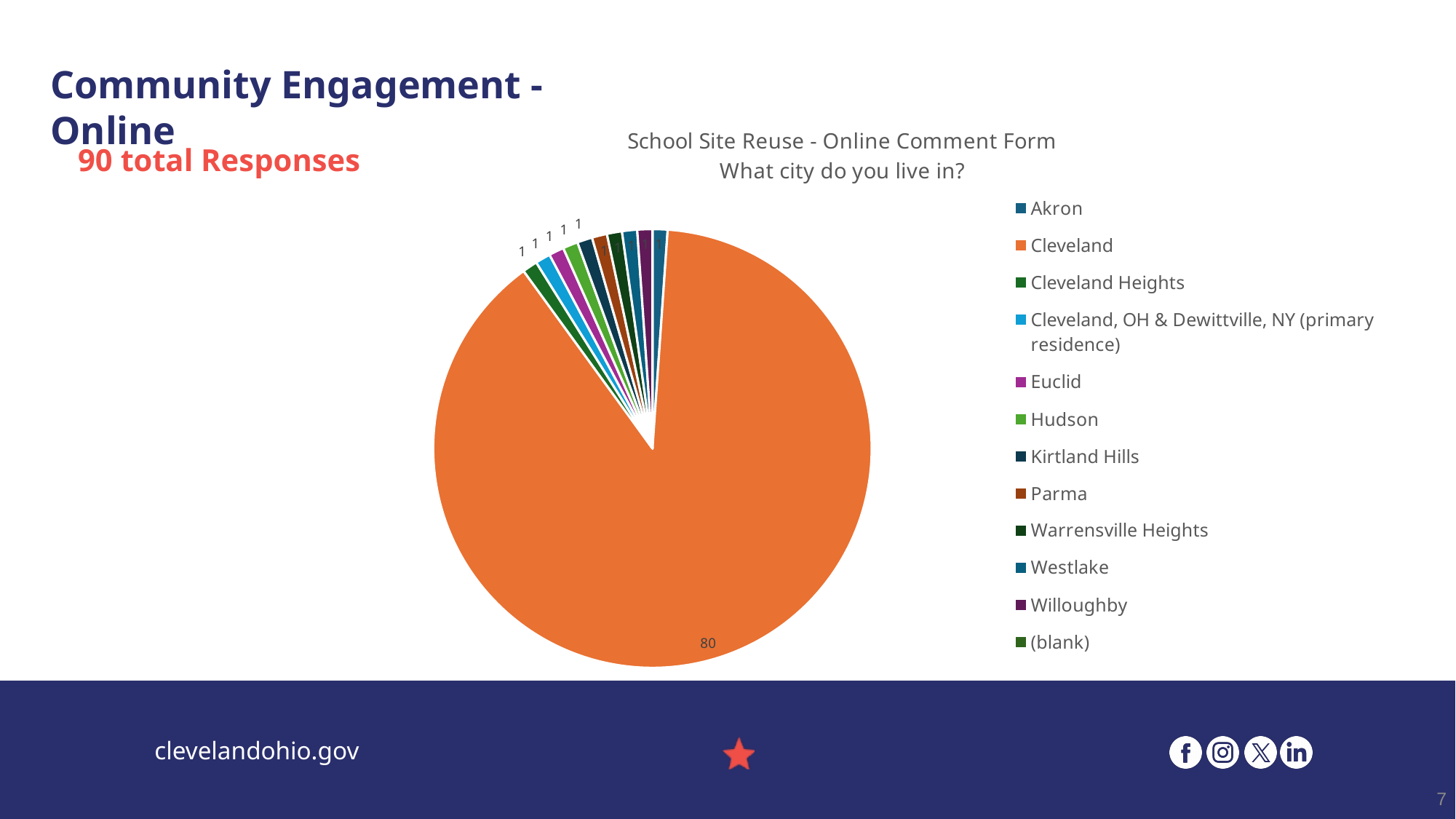
Which is larger, the slice for Parma or the slice for Cleveland? Cleveland How many responses are shown for Cleveland? 80 What is the last entry listed in the legend? (blank) What colour is the Cleveland slice? orange What is the title of the chart? School Site Reuse - Online Comment Form What city do you live in? What is the difference between the Cleveland value and the Akron value? 79 How many categories does the legend list? 12 Which city has the largest slice of the pie? Cleveland What type of chart is shown on the slide? pie chart How many responses are shown for Akron? 1 Which is larger, the slice for Cleveland or the slice for Akron? Cleveland